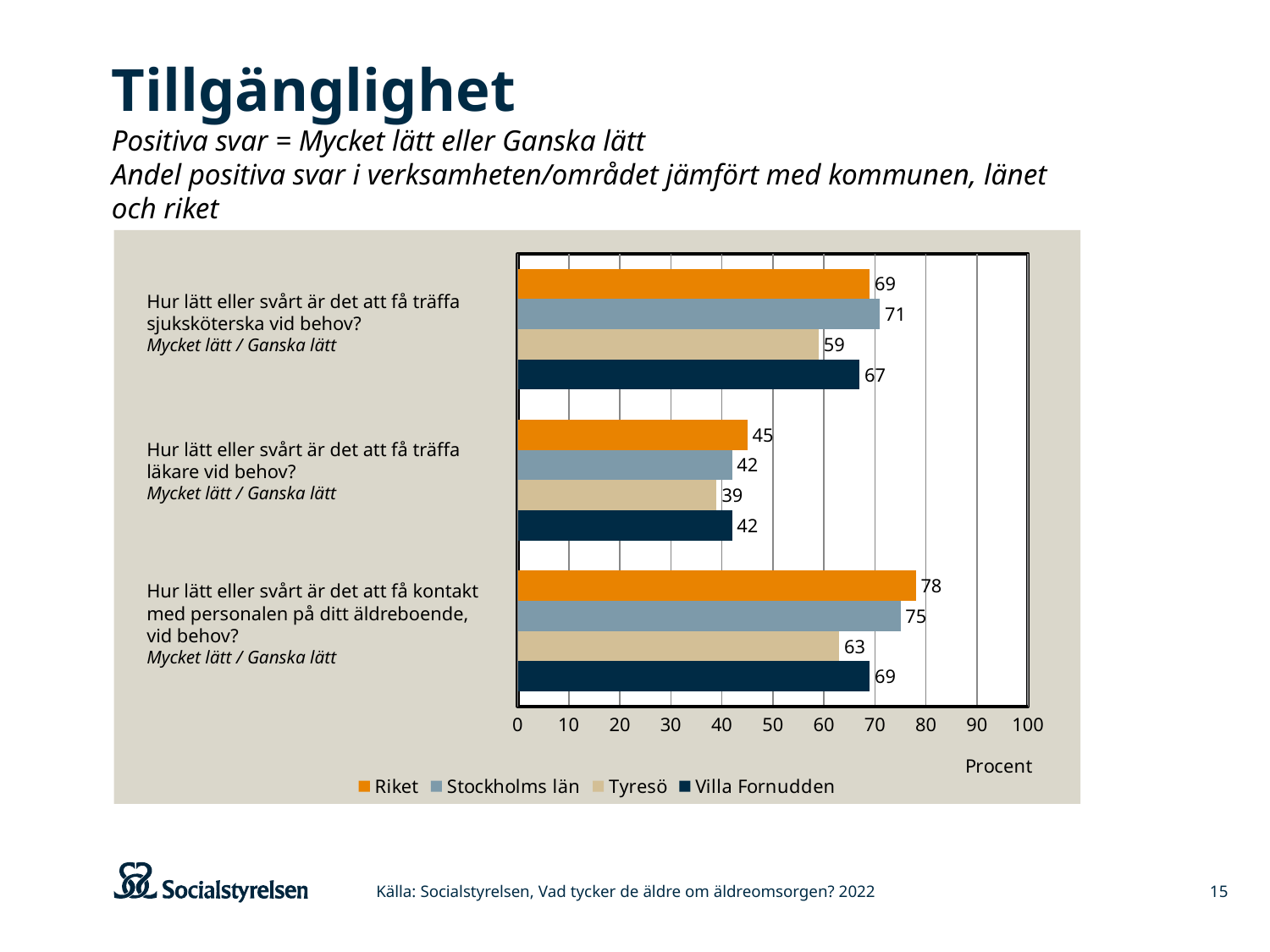
What is the value for Tyresö on the question about meeting a doctor when needed (träffa läkare vid behov)? 39 What is the difference between Riket and Tyresö on the question about getting in contact with staff at the care home? 15 How many series does the legend list? 4 Which is larger on the question about meeting a nurse when needed: Villa Fornudden or Tyresö? Villa Fornudden Which series has the highest value on the question about meeting a nurse when needed? Stockholms län What kind of chart is shown on the slide? Bar chart What unit label is shown below the x axis? Procent What is the value for Riket on the question about meeting a nurse when needed (träffa sjuksköterska vid behov)? 69 What is the value for Villa Fornudden on the question about getting in contact with staff at the care home (kontakt med personalen)? 69 What is the value for Stockholms län on the question about getting in contact with staff at the care home? 75 How many questions (categories) are shown on the chart? 3 Which series has the lowest value on the question about meeting a doctor when needed? Tyresö